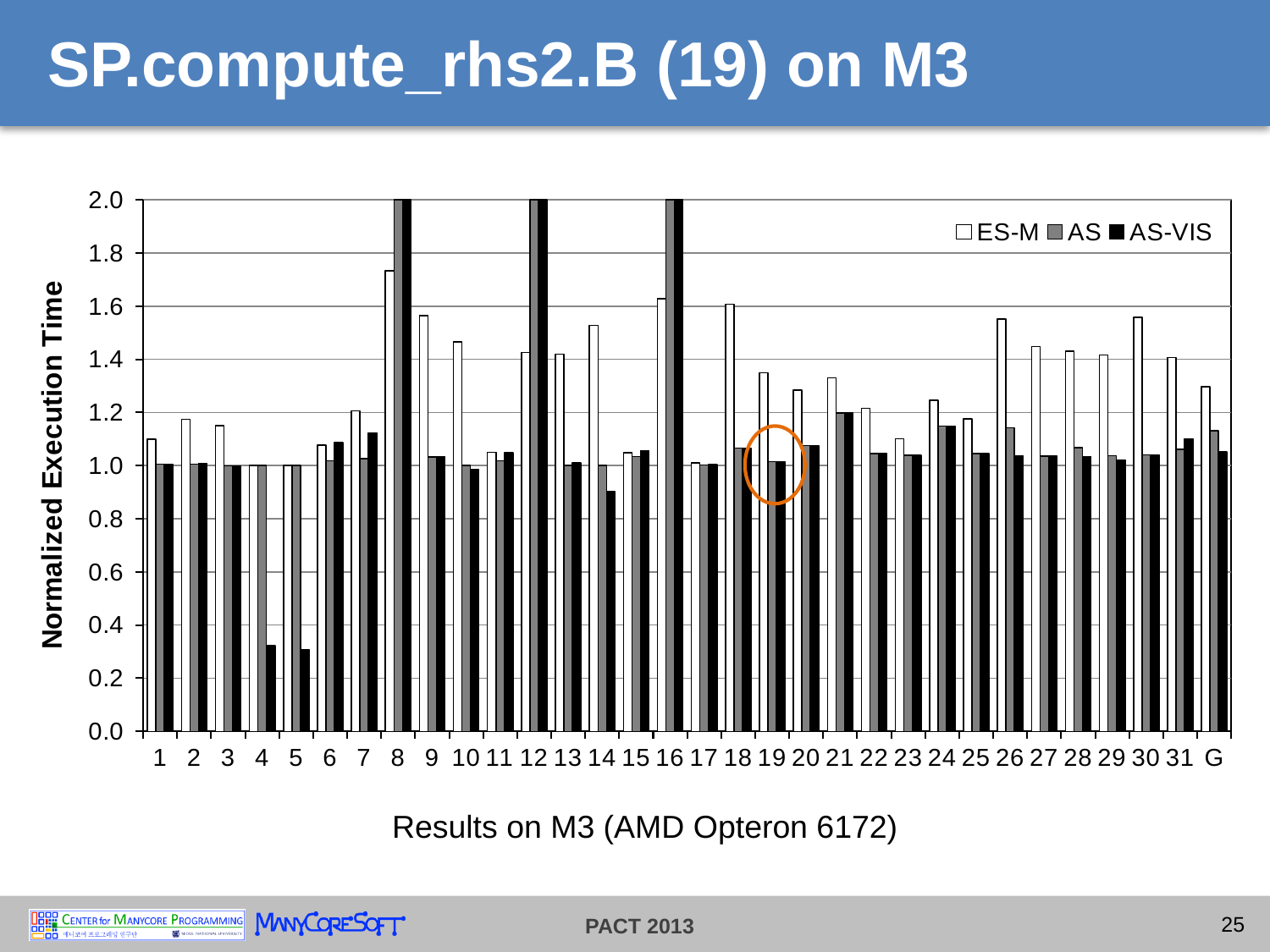
Is the ES-M value for category 26 greater or less than 1.4? greater Is the AS-VIS value for category 4 greater or less than 0.4? less Is the AS-VIS value for category 14 greater or less than 1.0? less How many series does the legend list? 3 For category 4, which is larger: the ES-M value or the AS-VIS value? ES-M How many categories are shown along the x axis? 32 For category 8, which is larger: the ES-M value or the AS value? AS What is the label of the y axis? Normalized Execution Time What are the series names listed in the legend? ES-M, AS, AS-VIS What kind of chart is shown on the slide? bar chart